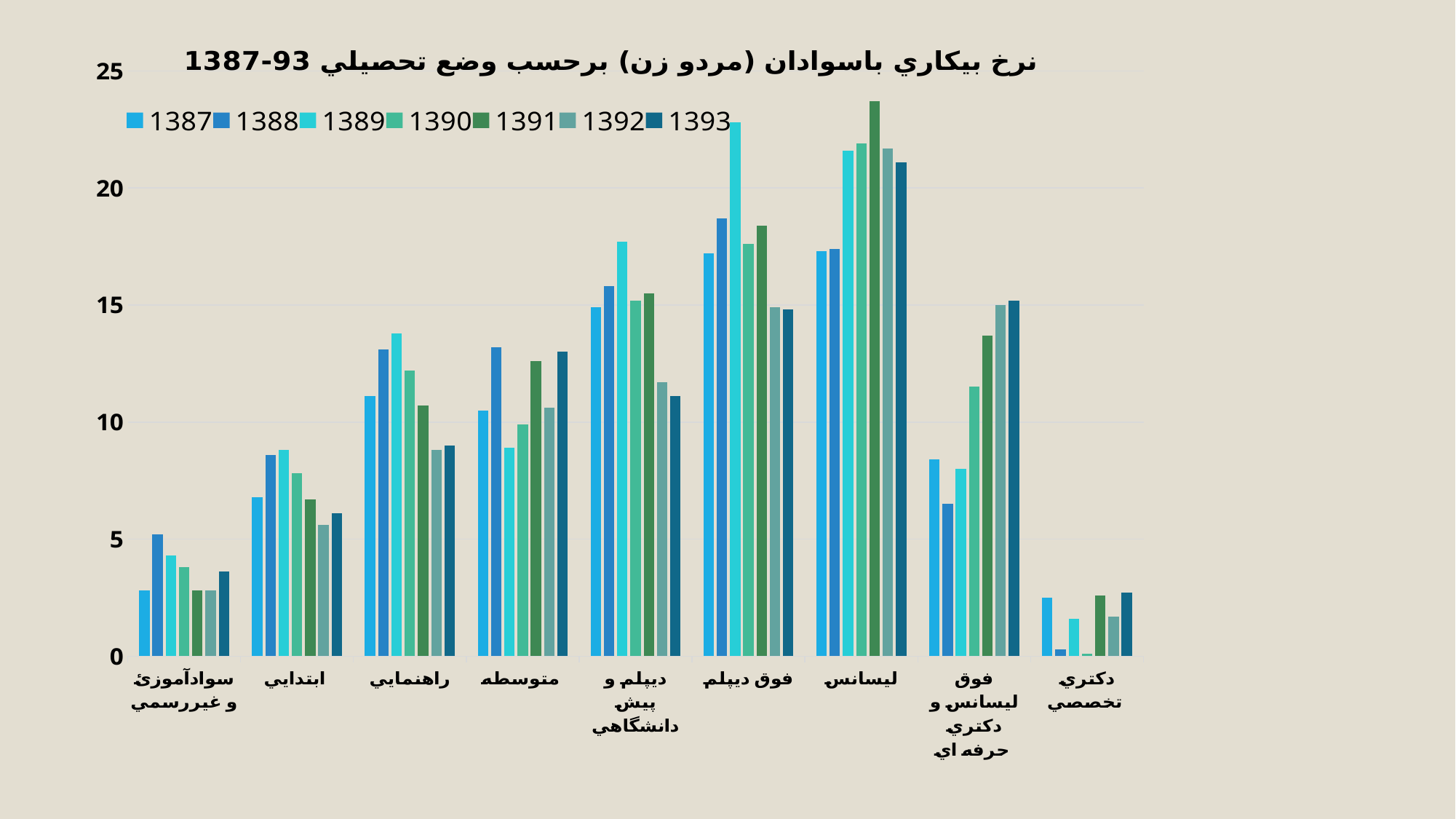
How many series does the legend list? 7 What kind of chart is shown on the slide? bar chart Within the دكتري تخصصي category, which year has the lowest bar? 1390 How many education-level categories are shown on the x axis? 9 Is the value for 1389 in the فوق ديپلم category greater or less than 20? greater Is the value for 1391 in the متوسطه category greater or less than 10? greater In the متوسطه category, which is larger: the value for 1388 or the value for 1389? 1388 Within the ليسانس category, which year has the highest bar? 1391 Which years are listed in the legend? 1387, 1388, 1389, 1390, 1391, 1392, 1393 Is the value for 1388 in the ابتدايي category greater or less than 10? less What is the title of the chart? نرخ بيكاري باسوادان (مردو زن) برحسب وضع تحصيلي 1387-93